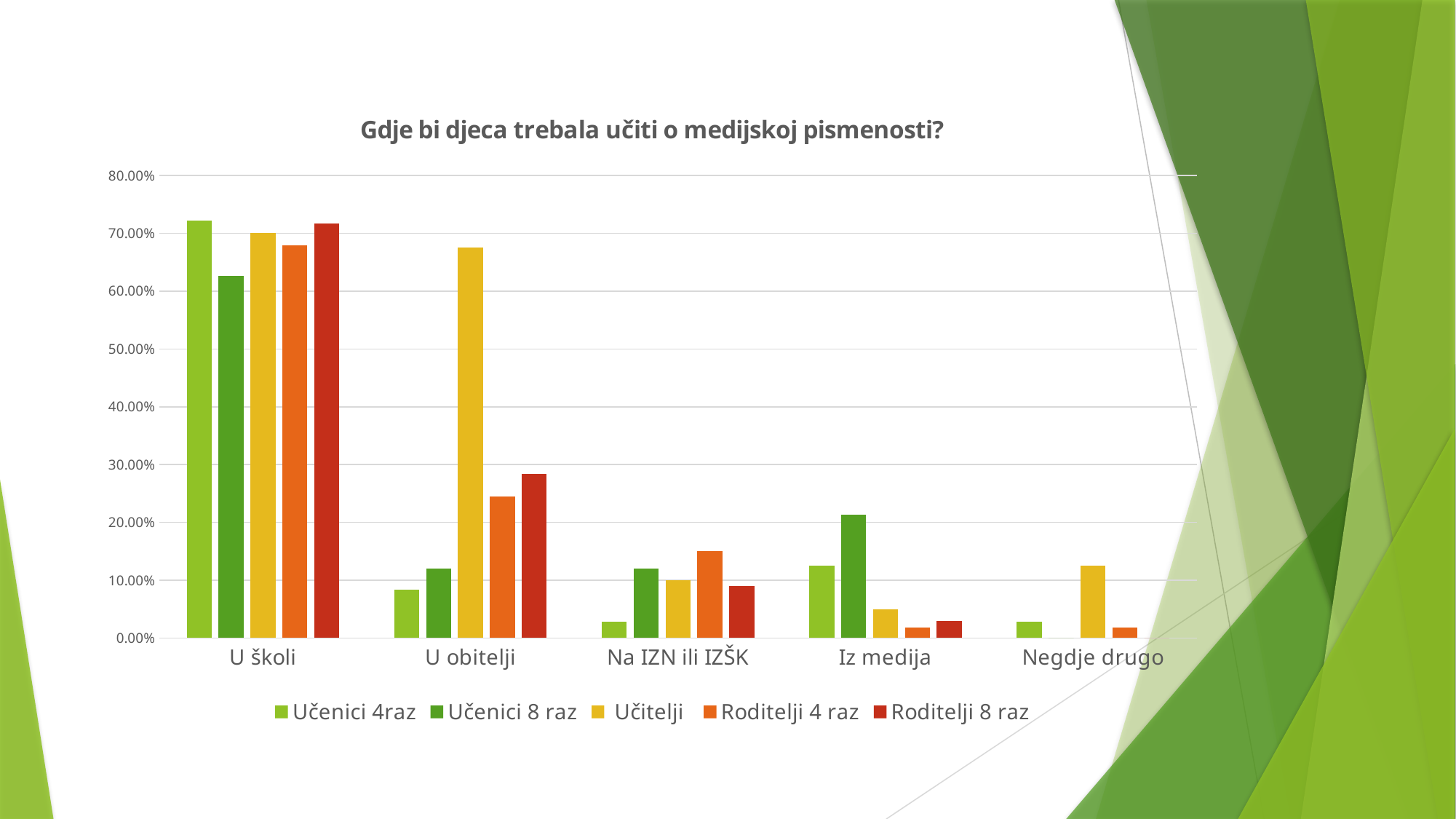
How many series does the legend list? 5 What kind of chart is shown on the slide? bar chart Is the value for Roditelji 4 raz in the Na IZN ili IZŠK category greater or less than 20.00%? less In which category is the Učenici 4raz bar highest? U školi Which series is shown in dark red in the legend? Roditelji 8 raz What is the title of the chart? Gdje bi djeca trebala učiti o medijskoj pismenosti? Is the value for Učenici 8 raz in the Iz medija category greater or less than 10.00%? greater In the U školi category, which series has the lowest bar? Učenici 8 raz In the Iz medija category, which is larger: Učenici 4raz or Učenici 8 raz? Učenici 8 raz In the U obitelji category, which is larger: Roditelji 4 raz or Roditelji 8 raz? Roditelji 8 raz Is the value for Učitelji in the U obitelji category greater or less than 60.00%? greater How many categories are shown on the x axis? 5